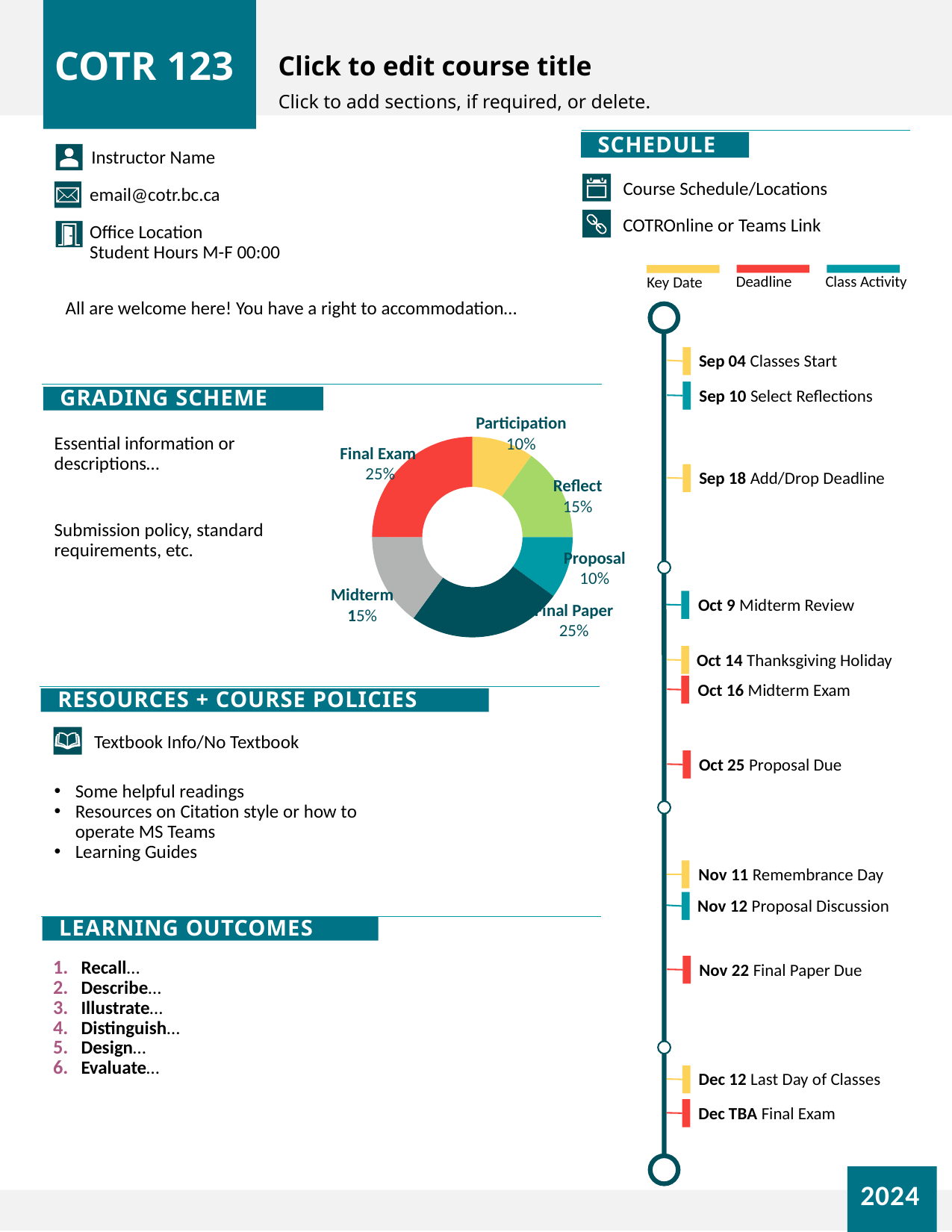
In the Grading Scheme chart, what percentage is assigned to the Proposal? 10% In the Grading Scheme chart, what is the combined share of the Final Exam and the Midterm? 40% In the Grading Scheme chart, what is the largest share assigned to any single component? 25% In the Grading Scheme chart, what percentage is assigned to Participation? 10% How many grading components are shown in the Grading Scheme chart? 6 In the Grading Scheme chart, how many percentage points larger is the Final Paper share than the Proposal share? 15 percentage points In the Grading Scheme chart, which is worth more: the Final Exam or Reflect? Final Exam In the Grading Scheme chart, what percentage is assigned to Reflect? 15% In the Grading Scheme chart, what percentage is assigned to the Midterm? 15% In the Grading Scheme chart, which is worth more: the Midterm or the Proposal? Midterm What kind of chart is shown in the Grading Scheme section? Pie (donut) chart In the Grading Scheme chart, what percentage is assigned to the Final Paper? 25%